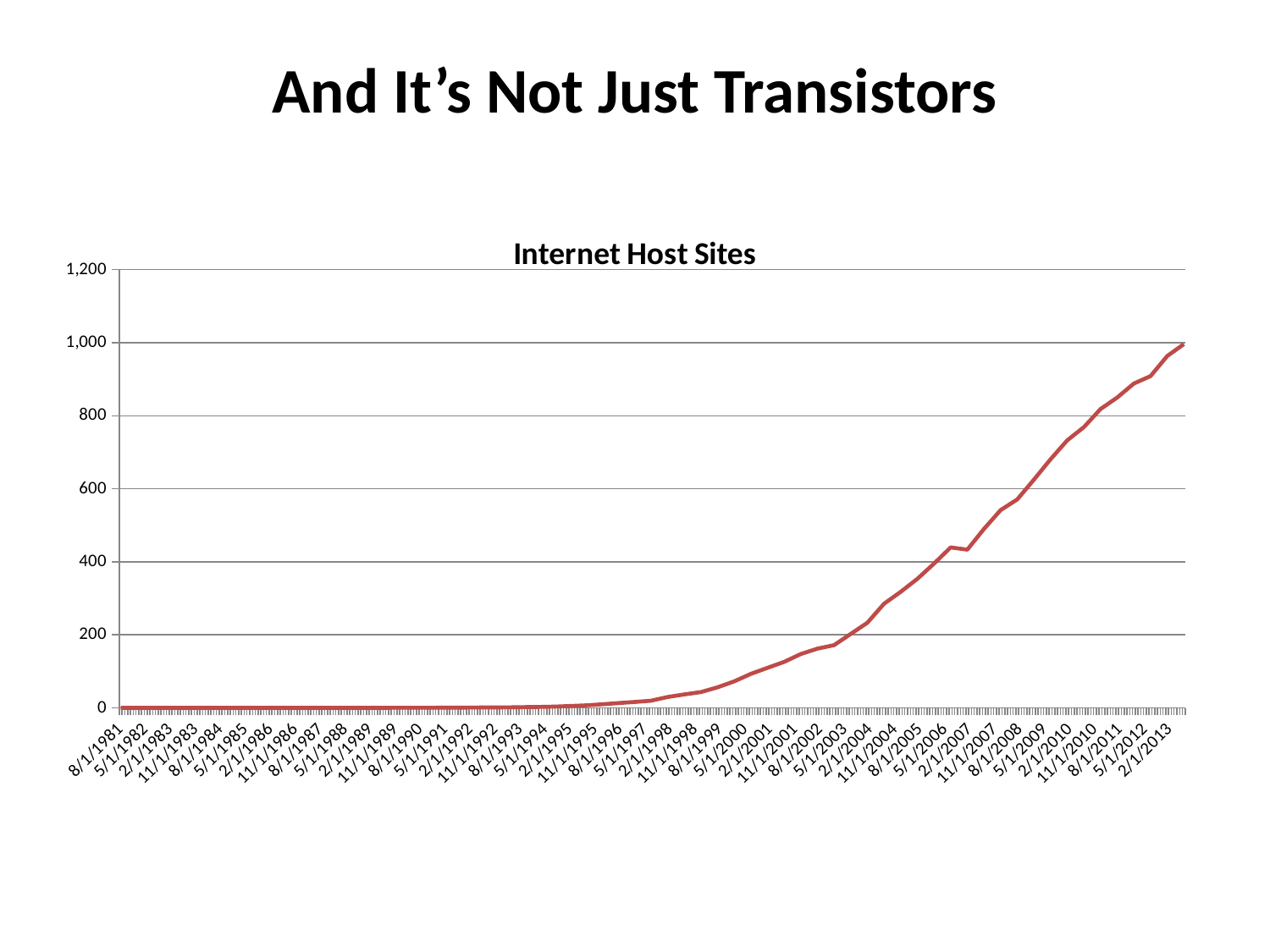
Is the value for 2/1/2013 greater or less than 800? greater Is the value for 11/1/2010 greater or less than 600? greater What is the highest value shown on the y axis of the chart? 1,200 What kind of chart is shown on the slide? line chart Is the value for 8/1/1999 greater or less than 200? less Which is larger, the value for 5/1/2000 or the value for 2/1/2009? 2/1/2009 Which is larger, the value for 8/1/2011 or the value for 8/1/2005? 8/1/2011 Do the values in the Internet Host Sites chart generally rise or fall from left to right along the x axis? rise What is the title of the chart? Internet Host Sites